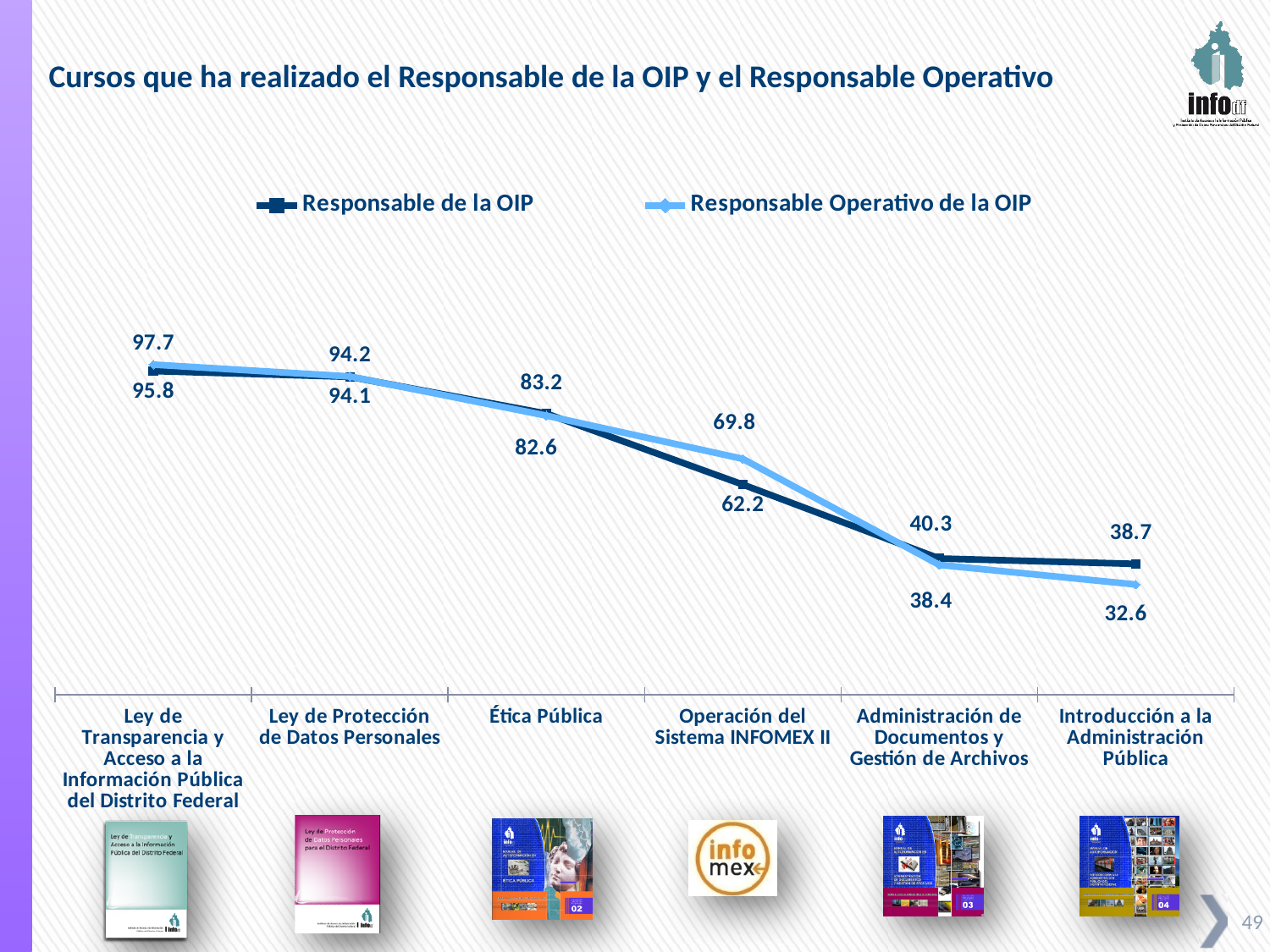
Which course has the lowest value for Responsable Operativo de la OIP? Introducción a la Administración Pública What is the value for Responsable Operativo de la OIP for Operación del Sistema INFOMEX II? 69.8 How many series does the legend list? 2 What is the value for Responsable de la OIP for Introducción a la Administración Pública? 38.7 What kind of chart is shown on the slide? Line chart For Operación del Sistema INFOMEX II, what is the difference between the Responsable Operativo de la OIP value and the Responsable de la OIP value? 7.6 What is the value for Responsable de la OIP for Ley de Transparencia y Acceso a la Información Pública del Distrito Federal? 95.8 Which course has the highest value for Responsable Operativo de la OIP? Ley de Transparencia y Acceso a la Información Pública del Distrito Federal What is the value for Responsable Operativo de la OIP for Ley de Transparencia y Acceso a la Información Pública del Distrito Federal? 97.7 How many course categories are shown on the x axis? 6 For Administración de Documentos y Gestión de Archivos, which series has the larger value? Responsable de la OIP What is the value for Responsable Operativo de la OIP for Introducción a la Administración Pública? 32.6